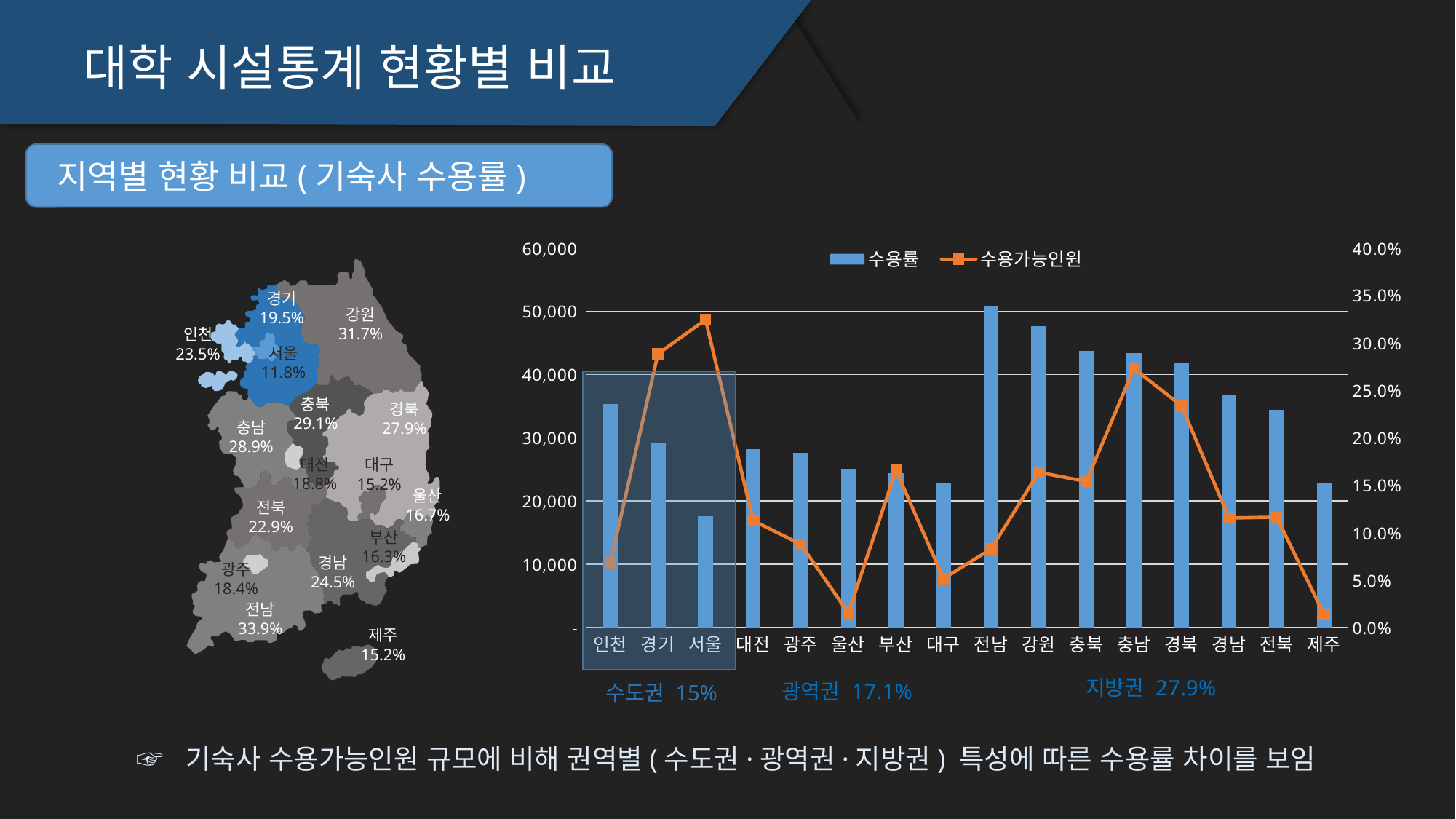
Which region has the shortest bar in the chart? 서울 Which region has the higher 수용가능인원 line point, 경기 or 대전? 경기 How many regions are shown along the x axis of the chart? 16 Which region has the tallest bar in the chart? 전남 How many series does the chart legend list? 2 What kind of chart is shown on the slide? Combined bar and line chart Which region has the taller bar, 강원 or 충북? 강원 Which region has the highest point on the 수용가능인원 line? 서울 Which series in the legend is drawn as a line with square markers? 수용가능인원 What percentage is printed below the chart for 지방권? 27.9% Is the 수용가능인원 line value for 서울 greater or less than 40,000? greater Is the 수용가능인원 line value for 대구 greater or less than 10,000? less